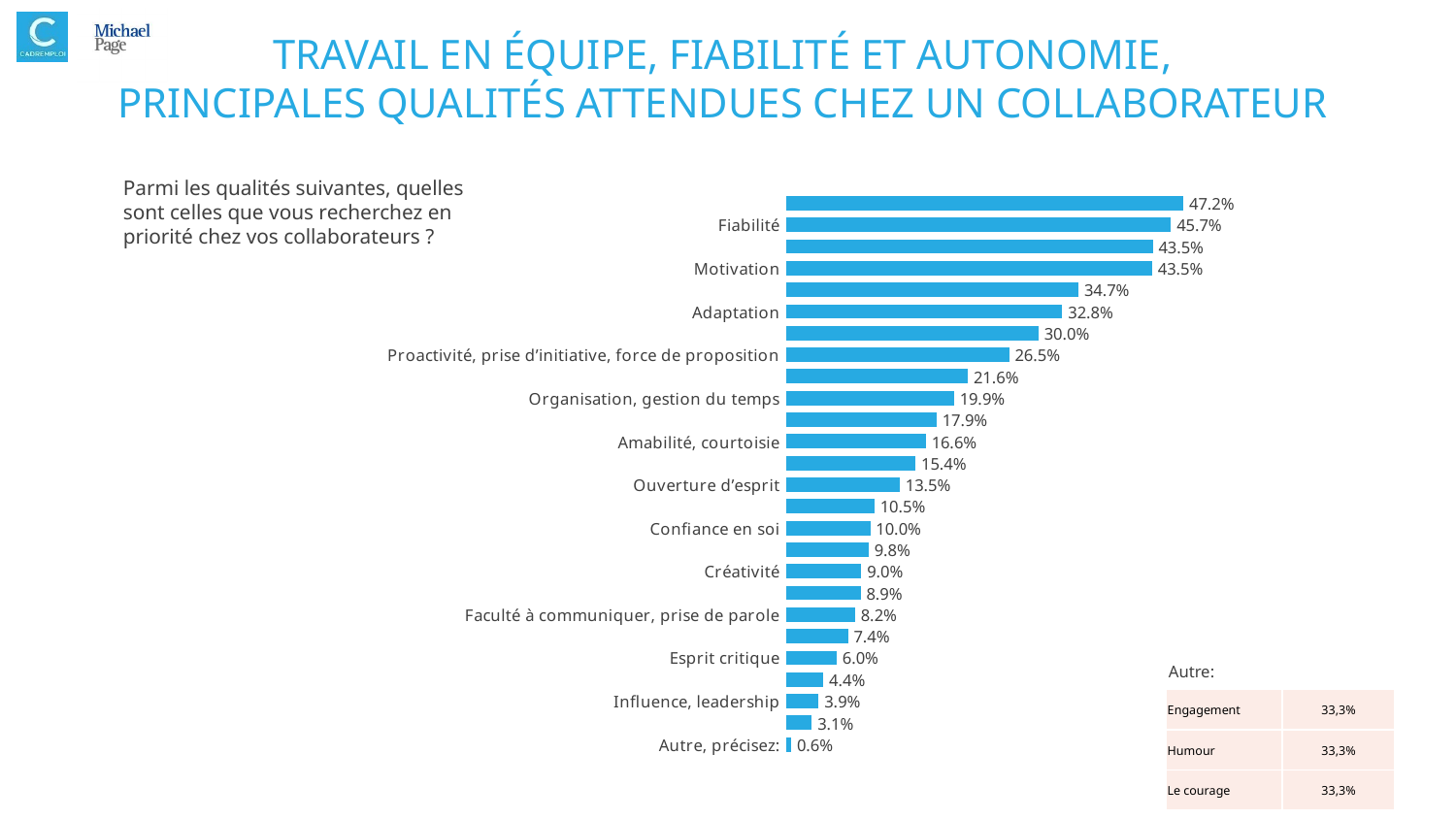
What is the difference between the values for Fiabilité and Motivation? 2.2 percentage points What type of chart is shown on the slide? bar chart Which labeled category has the lowest value? Autre, précisez: Which is larger, the value for Créativité or the value for Faculté à communiquer, prise de parole? Créativité What is the value for Motivation? 43.5% What is the value for Adaptation? 32.8% What is the value for Esprit critique? 6.0% What is the highest value shown on the chart? 47.2% What is the value for Organisation, gestion du temps? 19.9% What is the value for Fiabilité? 45.7% In the 'Autre' table, what value is shown for Humour? 33,3% How many bars are plotted on the chart? 26